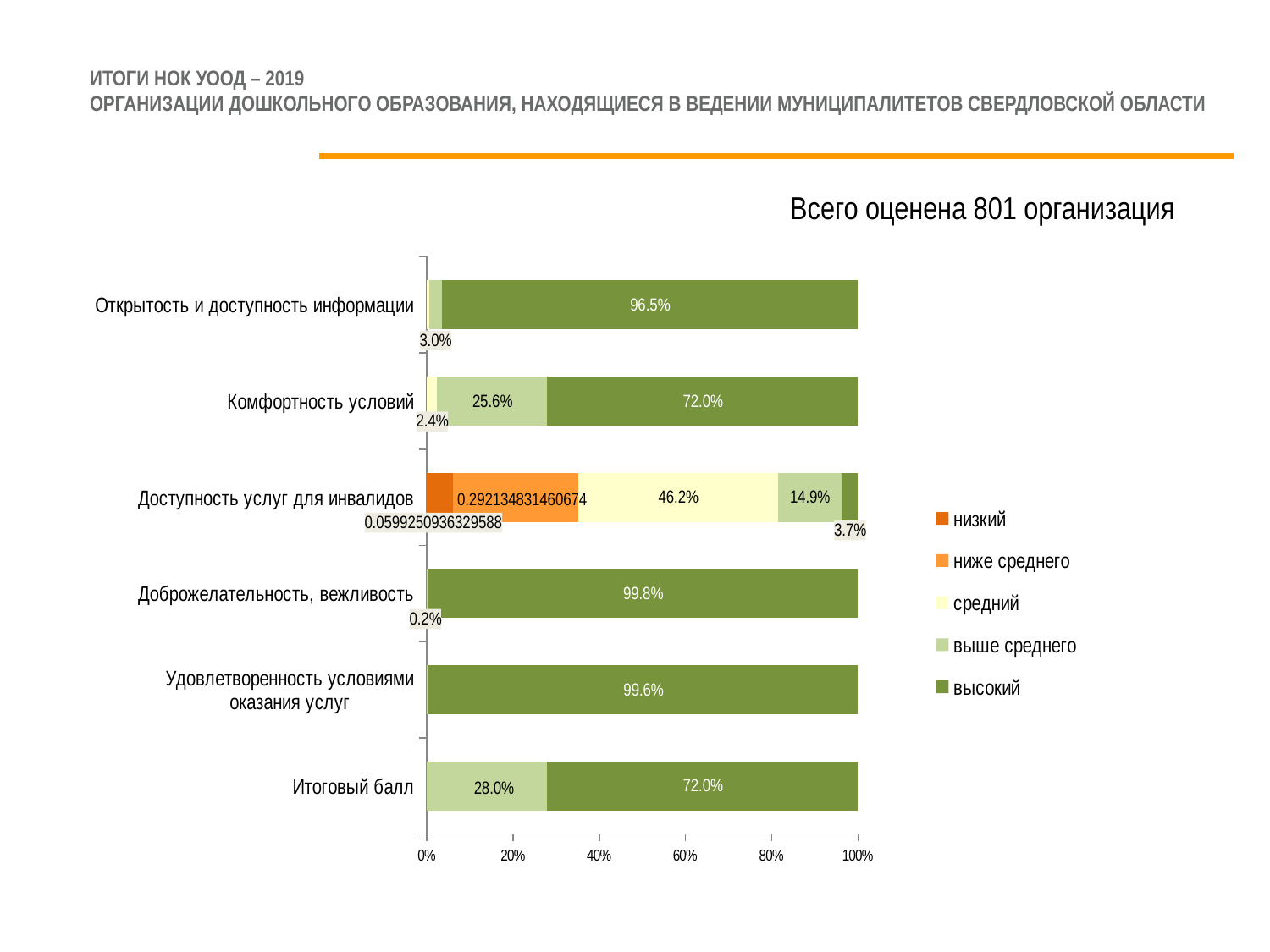
How many categories are plotted on the chart? 6 What is the value of the 'средний' segment for 'Доступность услуг для инвалидов'? 46.2% What is the value of the 'выше среднего' segment for 'Итоговый балл'? 28.0% What is the value of the 'высокий' segment for 'Доброжелательность, вежливость'? 99.8% What is the difference between the 'высокий' values for 'Доброжелательность, вежливость' and 'Удовлетворенность условиями оказания услуг'? 0.2% Which category has the lowest 'высокий' value? Доступность услуг для инвалидов What is the value of the 'высокий' segment for 'Открытость и доступность информации'? 96.5% Which category has the highest 'высокий' value? Доброжелательность, вежливость How many series does the legend list? 5 What kind of chart is shown on the slide? stacked bar chart What is the value of the 'выше среднего' segment for 'Комфортность условий'? 25.6% According to the text above the chart, how many organisations were evaluated in total? 801